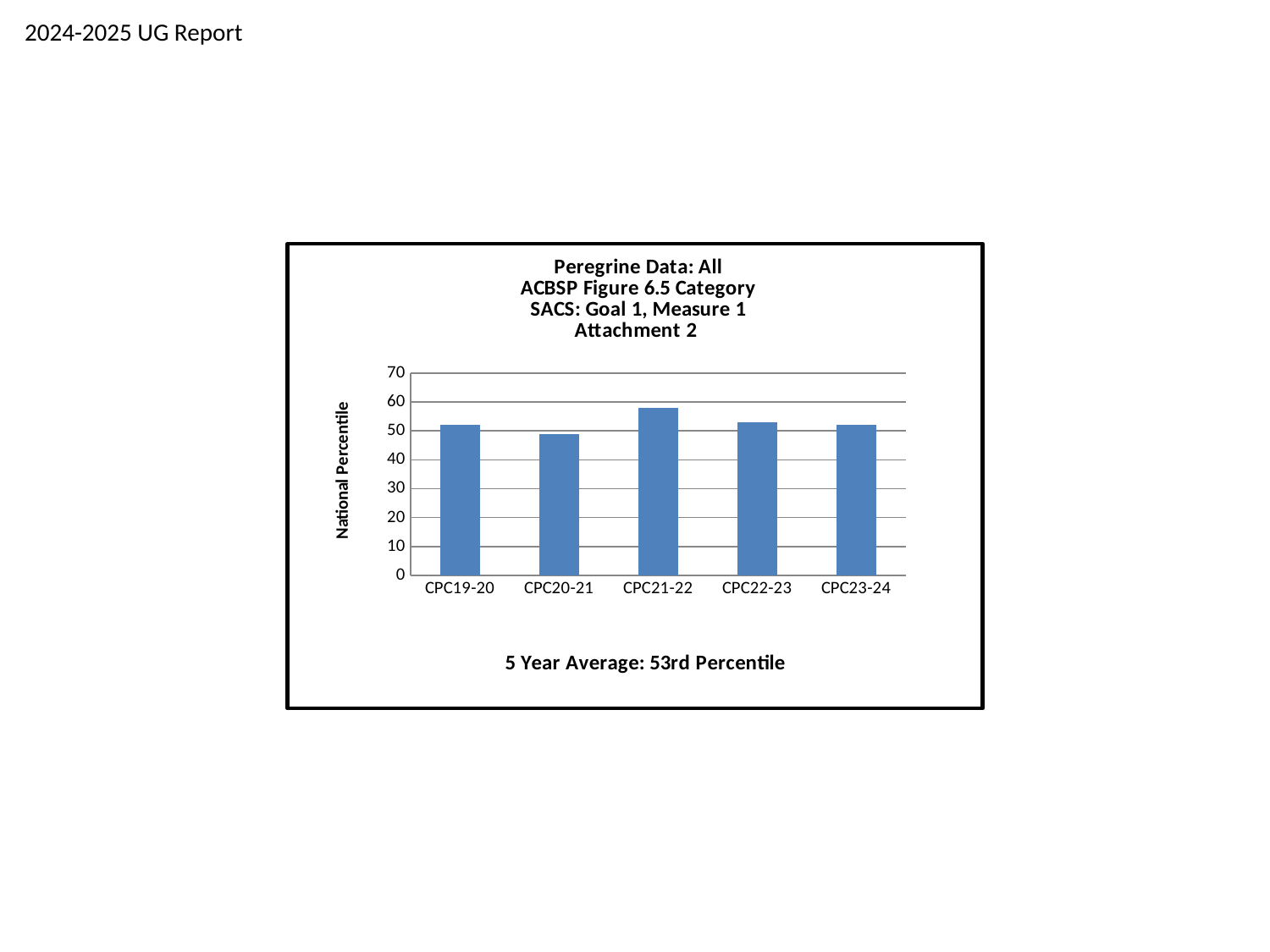
Is the value for CPC22-23 greater or less than 60? less Is the value for CPC20-21 greater or less than 40? greater How many categories are plotted on the x axis of the chart? 5 What is the label on the vertical axis of the chart? National Percentile What kind of chart is shown on the slide? bar chart Which is larger, the value for CPC21-22 or the value for CPC20-21? CPC21-22 What 5 year average is stated below the chart? 53rd Percentile Which category has the lowest national percentile? CPC20-21 Which category has the highest national percentile? CPC21-22 Is the value for CPC21-22 greater or less than 60? less Which is larger, the value for CPC22-23 or the value for CPC20-21? CPC22-23